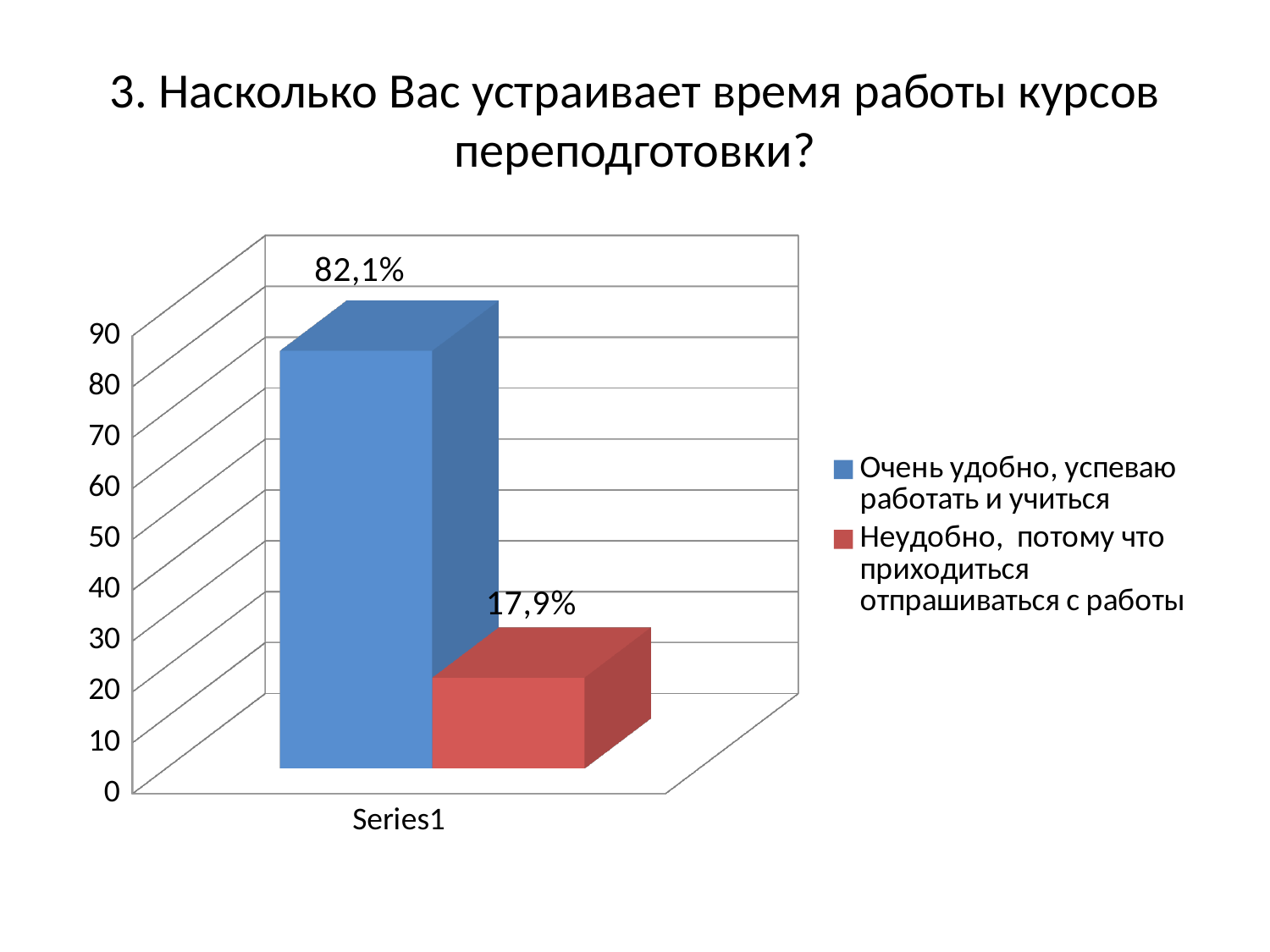
Is the value for "Неудобно, потому что приходиться отпрашиваться с работы" greater or less than 30? less What is the value for "Очень удобно, успеваю работать и учиться"? 82,1% What kind of chart is shown on the slide? bar chart Which legend entry has the lowest value? Неудобно, потому что приходиться отпрашиваться с работы What is the difference between the values for "Очень удобно, успеваю работать и учиться" and "Неудобно, потому что приходиться отпрашиваться с работы"? 64,2% How many bars are plotted on the chart? 2 How many series does the legend list? 2 Which legend entry has the highest value? Очень удобно, успеваю работать и учиться What is the value for "Неудобно, потому что приходиться отпрашиваться с работы"? 17,9% What colour is the bar for "Неудобно, потому что приходиться отпрашиваться с работы"? red Is the value for "Очень удобно, успеваю работать и учиться" greater or less than 70? greater Which is larger: the value for "Очень удобно, успеваю работать и учиться" or for "Неудобно, потому что приходиться отпрашиваться с работы"? Очень удобно, успеваю работать и учиться